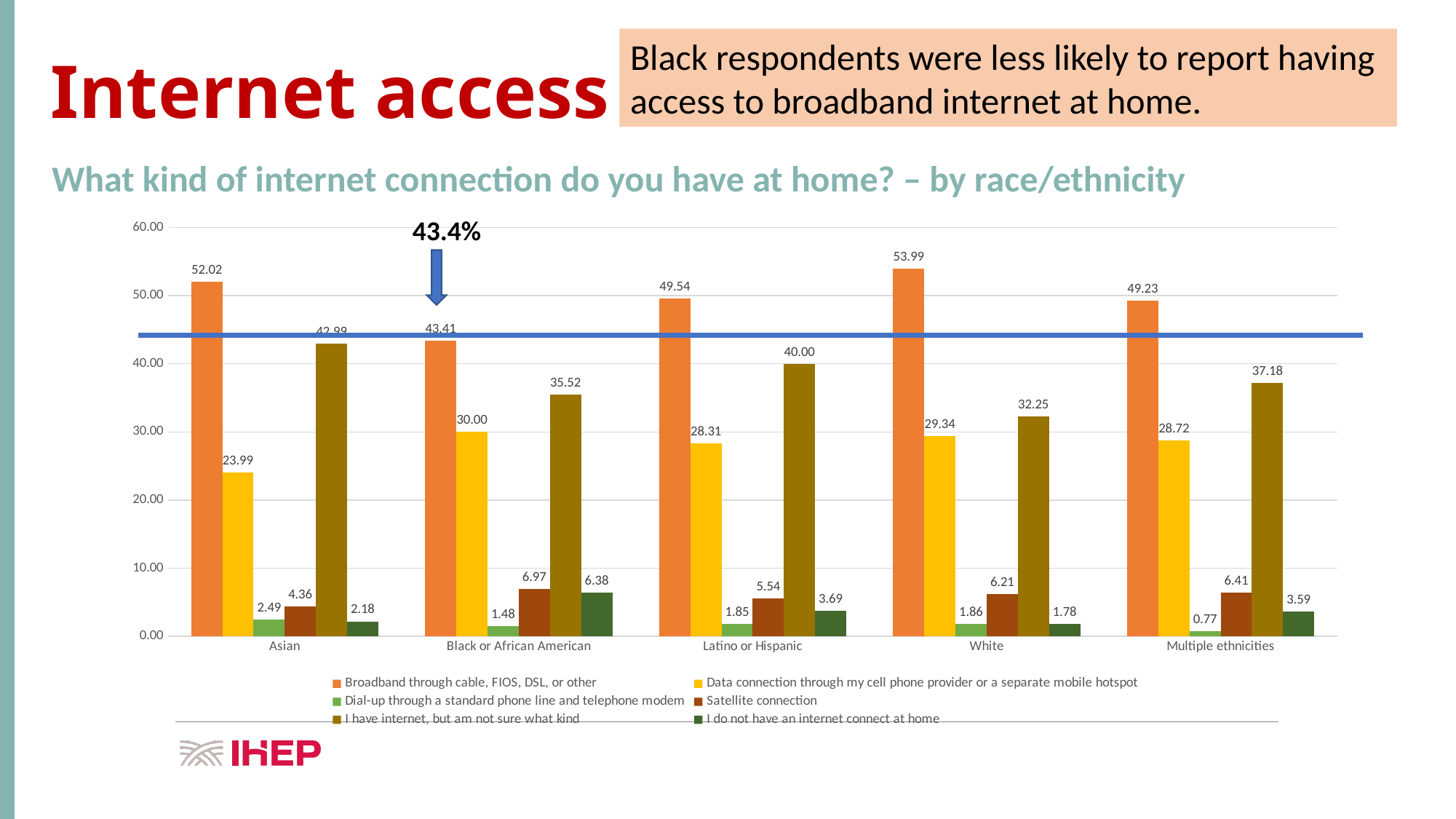
What is the difference between the Broadband values for White and Black or African American respondents? 10.58 What is the value for I have internet, but am not sure what kind for Latino or Hispanic respondents? 40.00 How many race/ethnicity categories are shown on the x axis? 5 Which race/ethnicity group has the highest value for Broadband through cable, FIOS, DSL, or other? White How many series does the legend list? 6 Which race/ethnicity group has the lowest value for Dial-up through a standard phone line and telephone modem? Multiple ethnicities What is the value for Broadband through cable, FIOS, DSL, or other for Black or African American respondents? 43.41 Is the Broadband value for Latino or Hispanic respondents greater or less than 40.00? greater Which is larger: the Satellite connection value for Black or African American respondents or for Multiple ethnicities? Black or African American What kind of chart is shown on the slide? bar chart What value does the arrow annotation above the Black or African American group point out? 43.4% What is the value for Data connection through my cell phone provider or a separate mobile hotspot for White respondents? 29.34